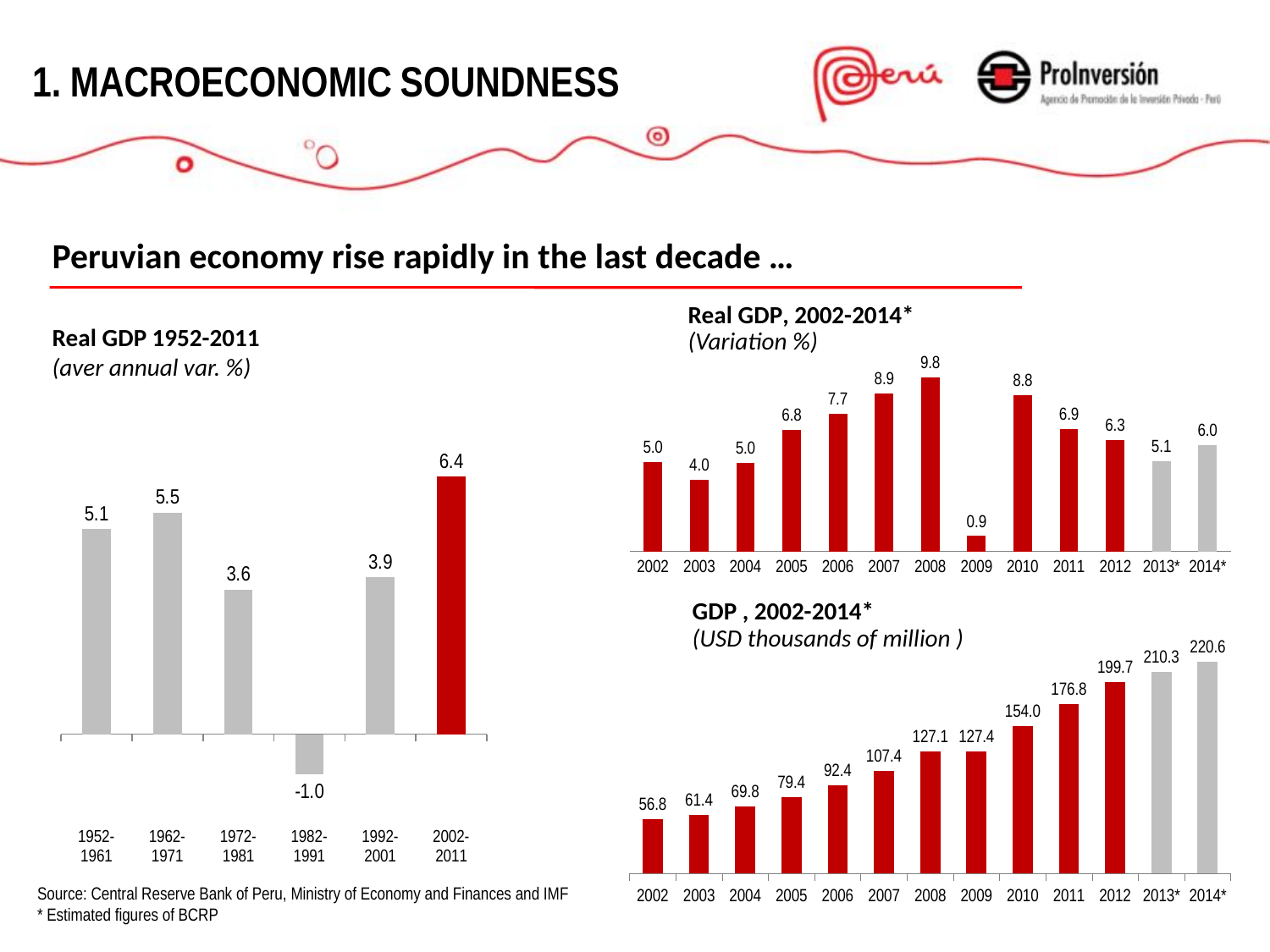
What type of chart is the 'GDP, 2002-2014*' chart? bar chart In the 'GDP, 2002-2014*' chart, what is the value for 2012? 199.7 In the 'GDP, 2002-2014*' chart, do the values rise or fall from 2002 to 2014*? rise In the 'Real GDP, 2002-2014*' chart, which year has the lowest value? 2009 In the 'Real GDP, 2002-2014*' chart, which is larger, the value for 2010 or the value for 2011? 2010 In the 'Real GDP 1952-2011' chart, which period has the highest value? 2002-2011 In the 'Real GDP 1952-2011' chart, how many periods are shown? 6 In the 'Real GDP 1952-2011' chart, what is the difference between the values for 2002-2011 and 1992-2001? 2.5 In the 'Real GDP, 2002-2014*' chart, what is the value for 2008? 9.8 In the 'GDP, 2002-2014*' chart, what is the difference between the values for 2014* and 2002? 163.8 In the 'Real GDP 1952-2011' chart, what is the value for 1982-1991? -1.0 In the 'Real GDP, 2002-2014*' chart, what is the difference between the values for 2008 and 2009? 8.9